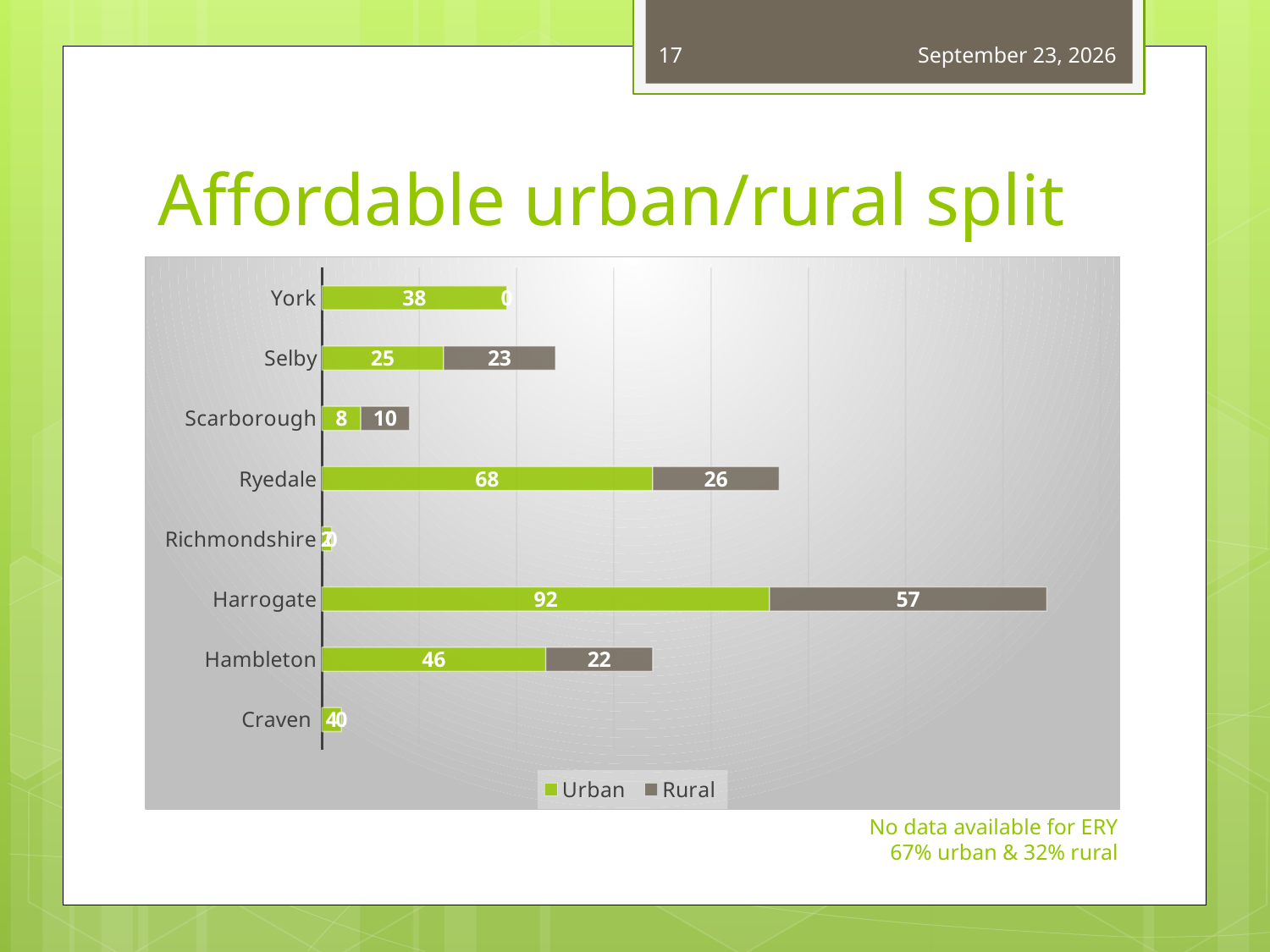
What is the difference between the Urban and Rural values for Hambleton? 24 Which district has the highest Urban value? Harrogate What is the Urban value for Selby? 25 How many series does the legend list? 2 What type of chart is shown on the slide? bar chart Which district has the highest Rural value? Harrogate What is the total of the stacked bar for Harrogate? 149 What is the Rural value for Ryedale? 26 What is the Rural value for Scarborough? 10 How many categories (districts) are shown on the chart? 8 What is the Urban value for Harrogate? 92 Which is larger for Scarborough, the Urban value or the Rural value? Rural